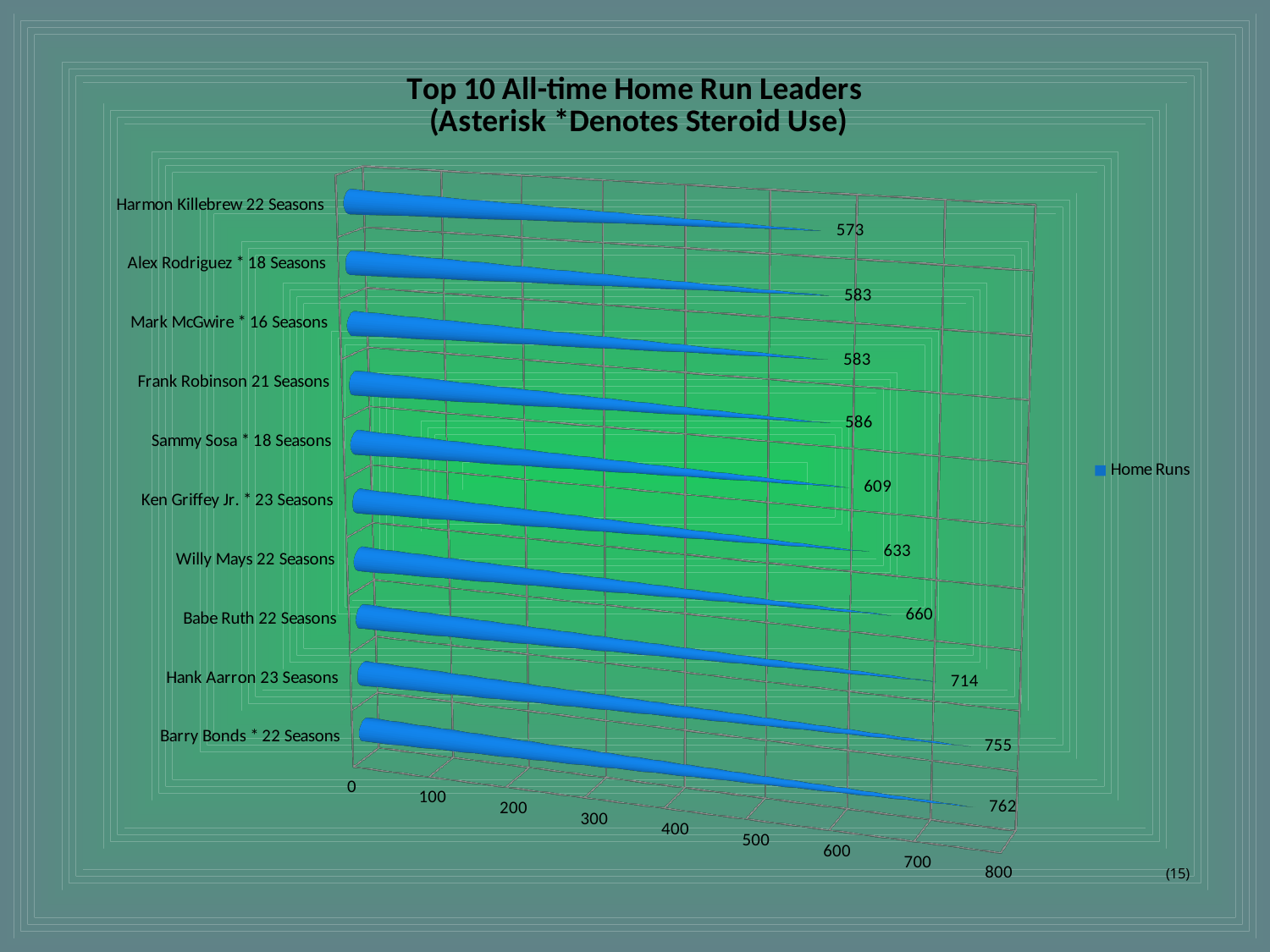
Which player has the lowest home run value on the chart? Harmon Killebrew 22 Seasons What is the value shown for Ken Griffey Jr. * 23 Seasons? 633 How many home runs does the chart show for Barry Bonds * 22 Seasons? 762 What kind of chart is shown on the slide? bar chart What is the title of the chart? Top 10 All-time Home Run Leaders (Asterisk *Denotes Steroid Use) How many players are listed on the chart? 10 Which player has the highest home run value on the chart? Barry Bonds * 22 Seasons Which is larger, the value for Sammy Sosa * 18 Seasons or the value for Frank Robinson 21 Seasons? Sammy Sosa * 18 Seasons How many series does the legend list? 1 Is the value for Hank Aarron 23 Seasons greater or less than 700? greater What is the difference between the values for Babe Ruth 22 Seasons and Willy Mays 22 Seasons? 54 What is the value shown for Hank Aarron 23 Seasons? 755